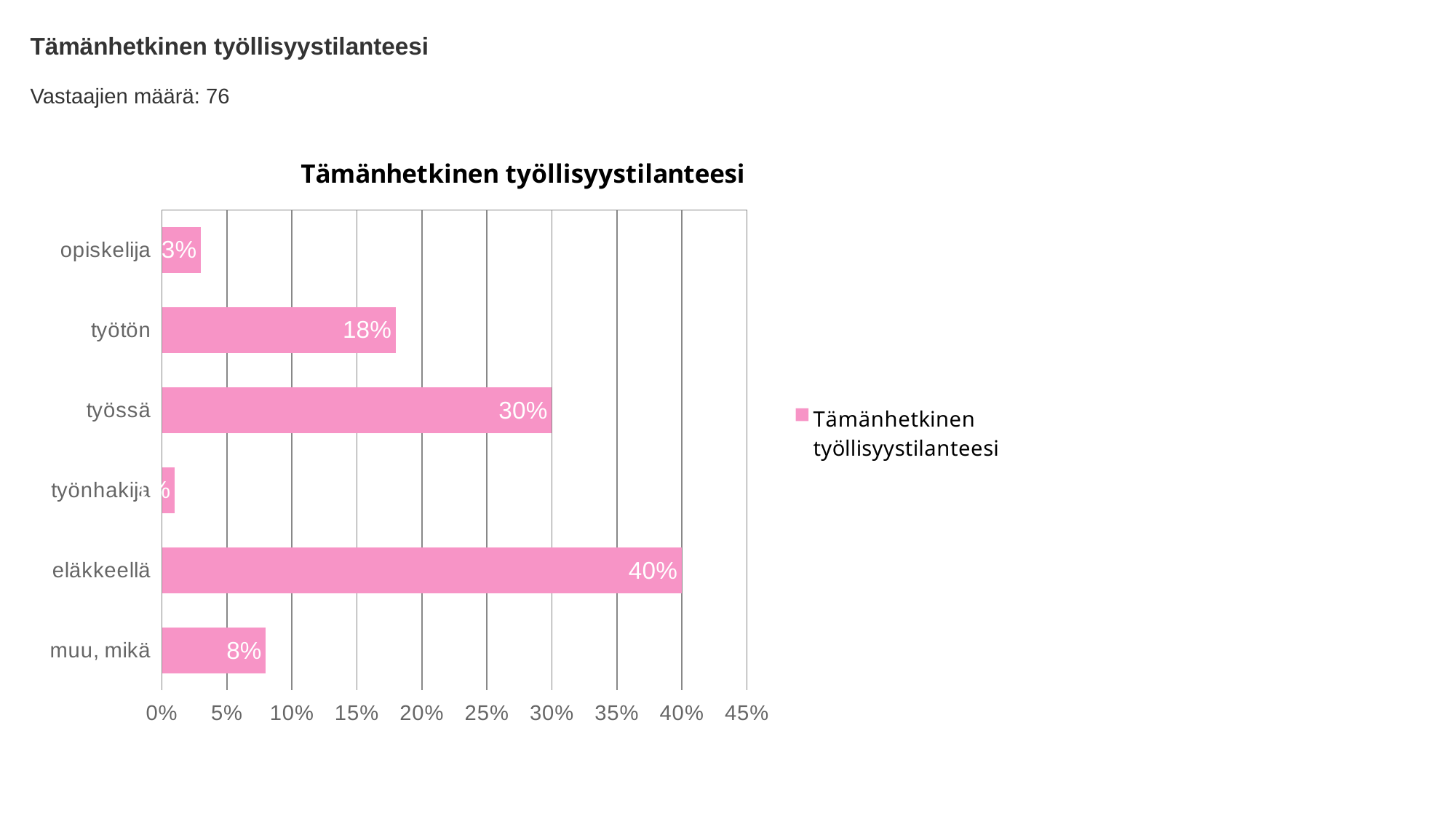
How many categories are shown in the chart? 6 Is the value for työnhakija greater or less than 5%? less Which category has the lowest value? työnhakija Which is larger, the value for työtön or the value for muu, mikä? työtön What is the title of the chart? Tämänhetkinen työllisyystilanteesi What is the value for muu, mikä? 8% What is the difference between the values for eläkkeellä and työssä? 10% What kind of chart is shown on the slide? bar chart What is the value for eläkkeellä? 40% Which category has the highest value? eläkkeellä What is the value for työtön? 18% What is the value for työssä? 30%